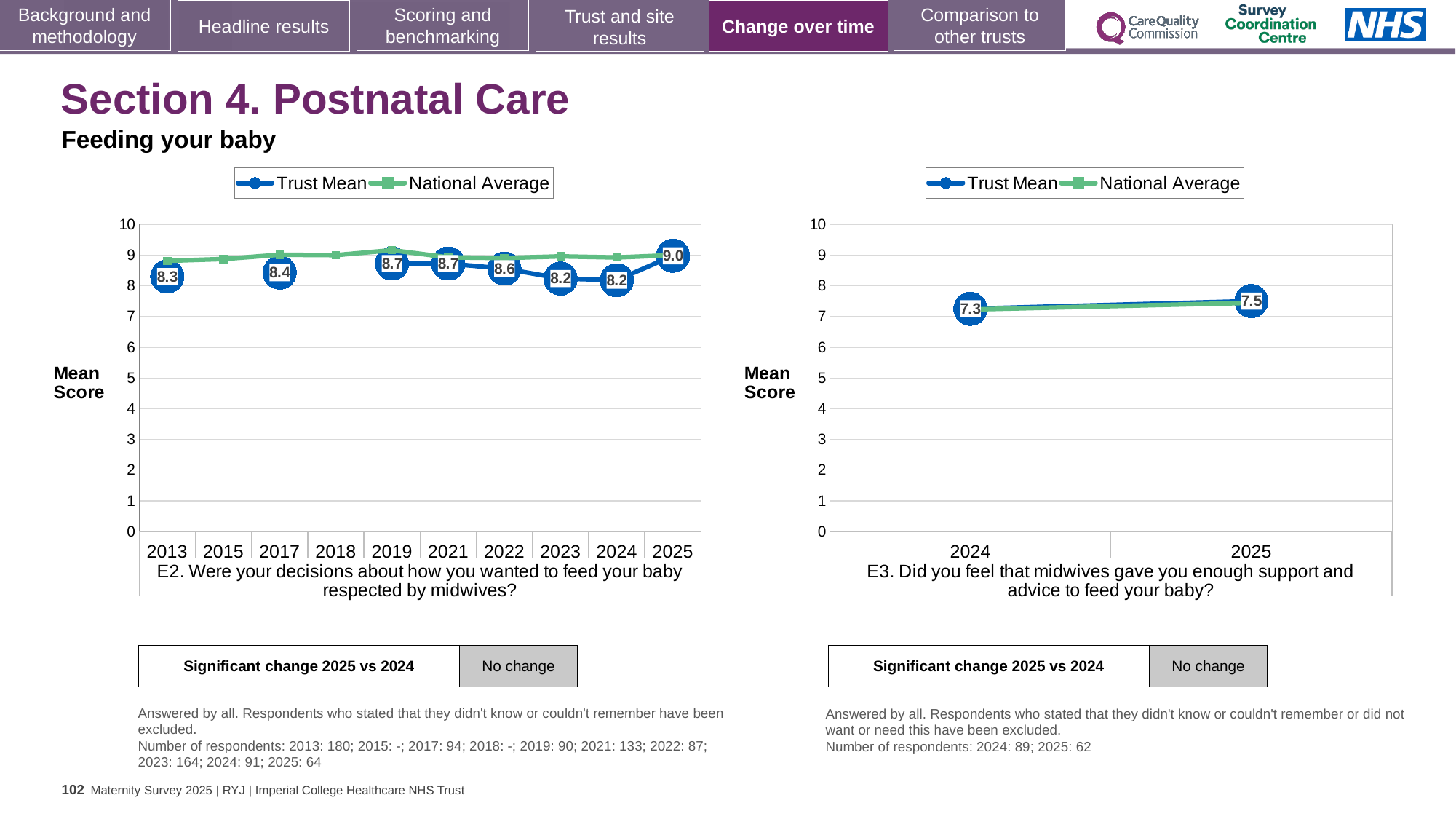
How many series does the legend of the E3 chart (right) list? 2 In the E3 chart (right), what is the Trust Mean for 2025? 7.5 In the E2 chart (left), which year has the highest Trust Mean? 2025 In the E2 chart (left), what is the Trust Mean for 2013? 8.3 In the E2 chart (left), is the Trust Mean for 2017 greater or less than 9? less In the E2 chart (left), what is the difference between the Trust Mean in 2025 and in 2024? 0.8 In the E2 chart (left), what is the Trust Mean for 2025? 9.0 In the E3 chart (right), did the Trust Mean rise or fall from 2024 to 2025? rise What type of chart is the E2 chart (left)? line chart In the E2 chart (left), what is the Trust Mean for 2023? 8.2 In the E3 chart (right), what is the Trust Mean for 2024? 7.3 In the E2 chart (left), how many years are shown on the x axis? 10